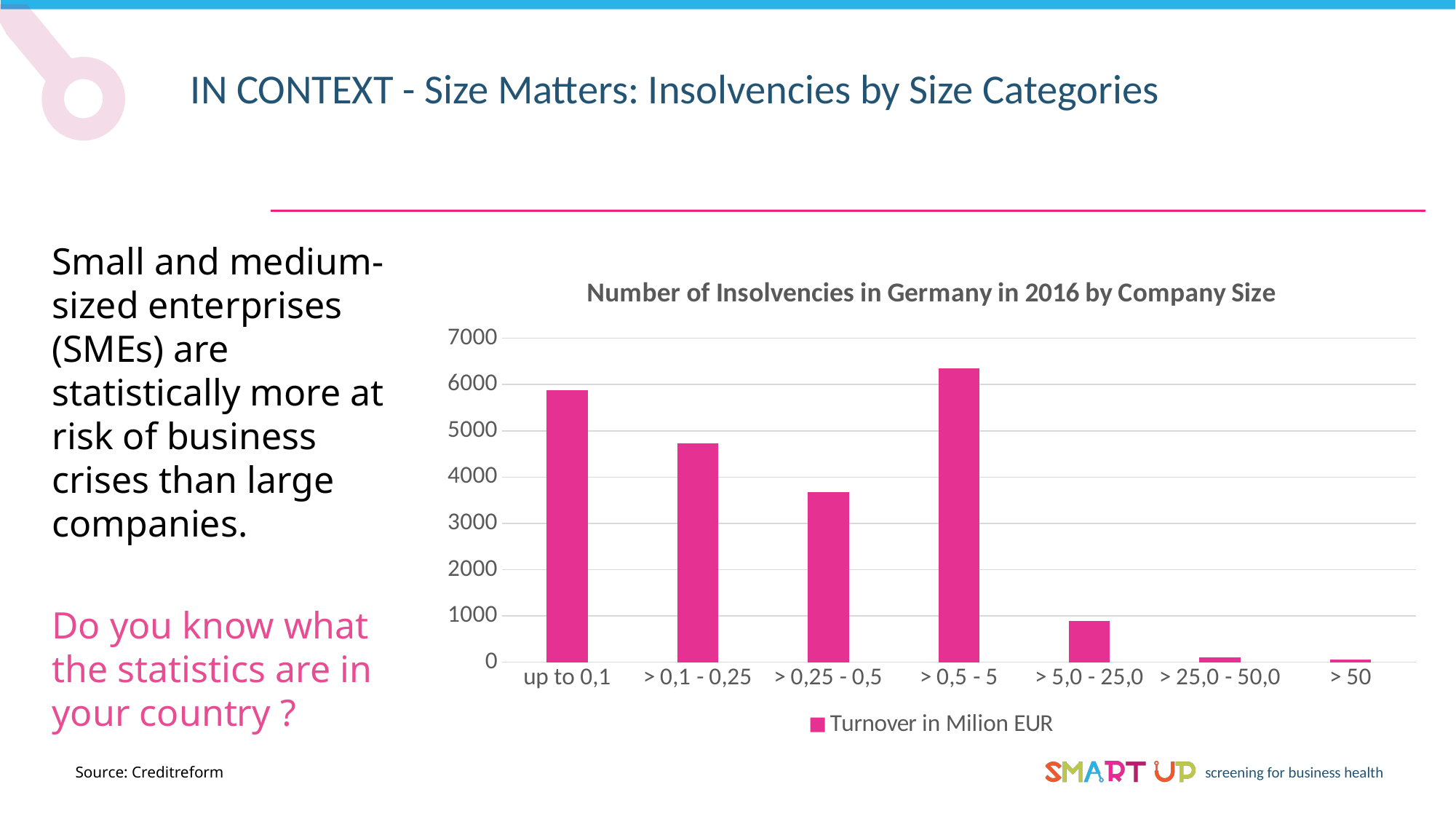
Is the value for '> 0,25 - 0,5' greater or less than 3000? greater What is the title of the chart? Number of Insolvencies in Germany in 2016 by Company Size Which has more insolvencies, 'up to 0,1' or '> 0,1 - 0,25'? up to 0,1 What is the legend entry of the chart? Turnover in Milion EUR What kind of chart is shown on the slide? bar chart How many series does the legend list? 1 Is the value for 'up to 0,1' greater or less than 5000? greater Is the value for '> 5,0 - 25,0' greater or less than 1000? less Which company size category has the highest number of insolvencies? > 0,5 - 5 How many company size categories are shown on the x axis? 7